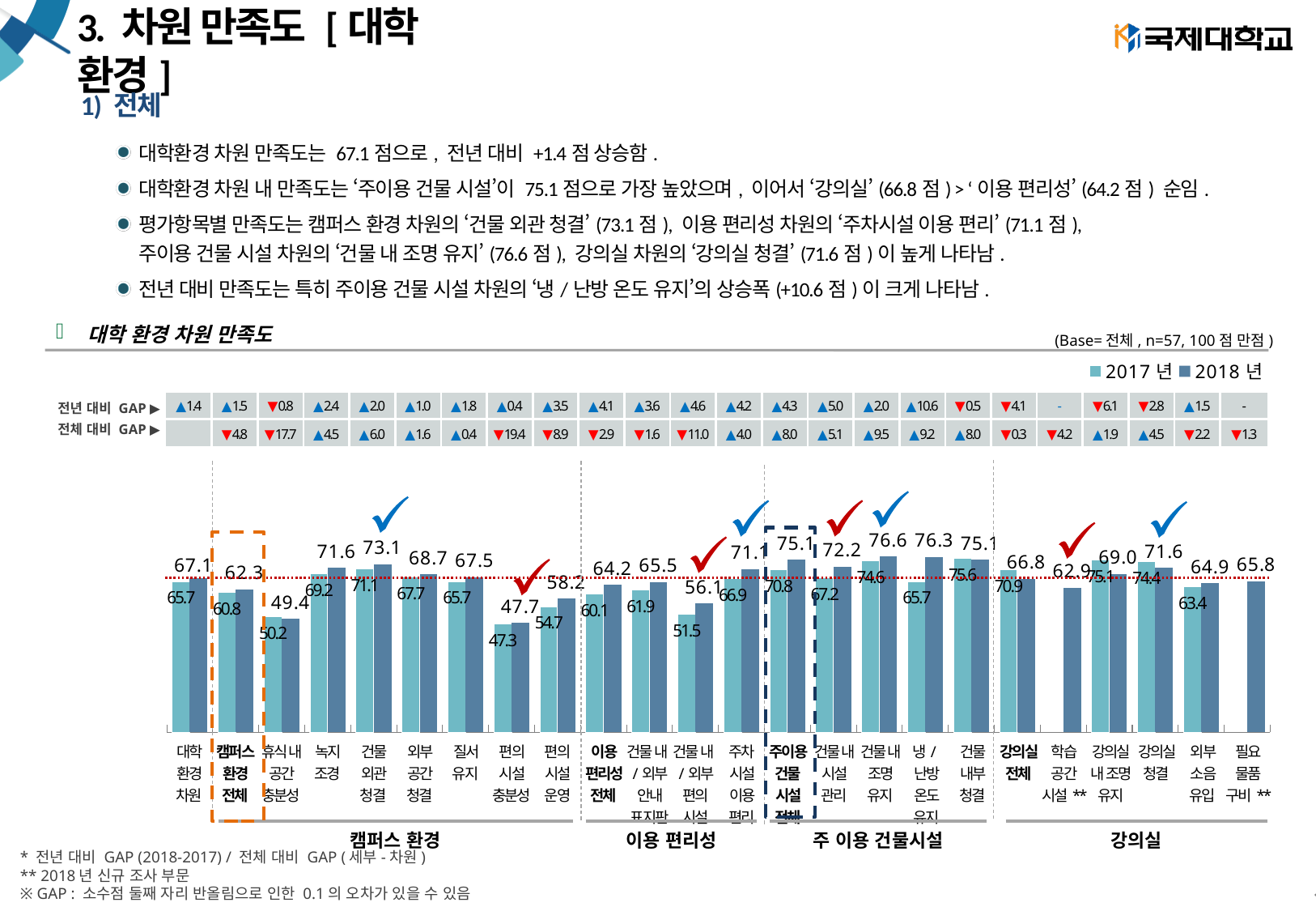
What is the 2018년 value for 건물 외관 청결? 73.1 What are the two series named in the legend? 2017년 and 2018년 What is the 2018년 value for 주차 시설 이용 편리? 71.1 What type of chart is shown on the slide? bar chart Which category has the highest 2018년 value? 건물 내 조명 유지 What is the difference between the 2018년 and 2017년 values for 냉/난방 온도 유지? 10.6 What is the 2017년 value for 냉/난방 온도 유지? 65.7 Which is larger for 강의실 전체: the 2017년 value or the 2018년 value? 2017년 What is the 2017년 value for 편의 시설 충분성? 47.3 What is the 2018년 value for 대학 환경 차원? 67.1 How many series does the legend list? 2 Which category has the lowest 2018년 value? 편의 시설 충분성